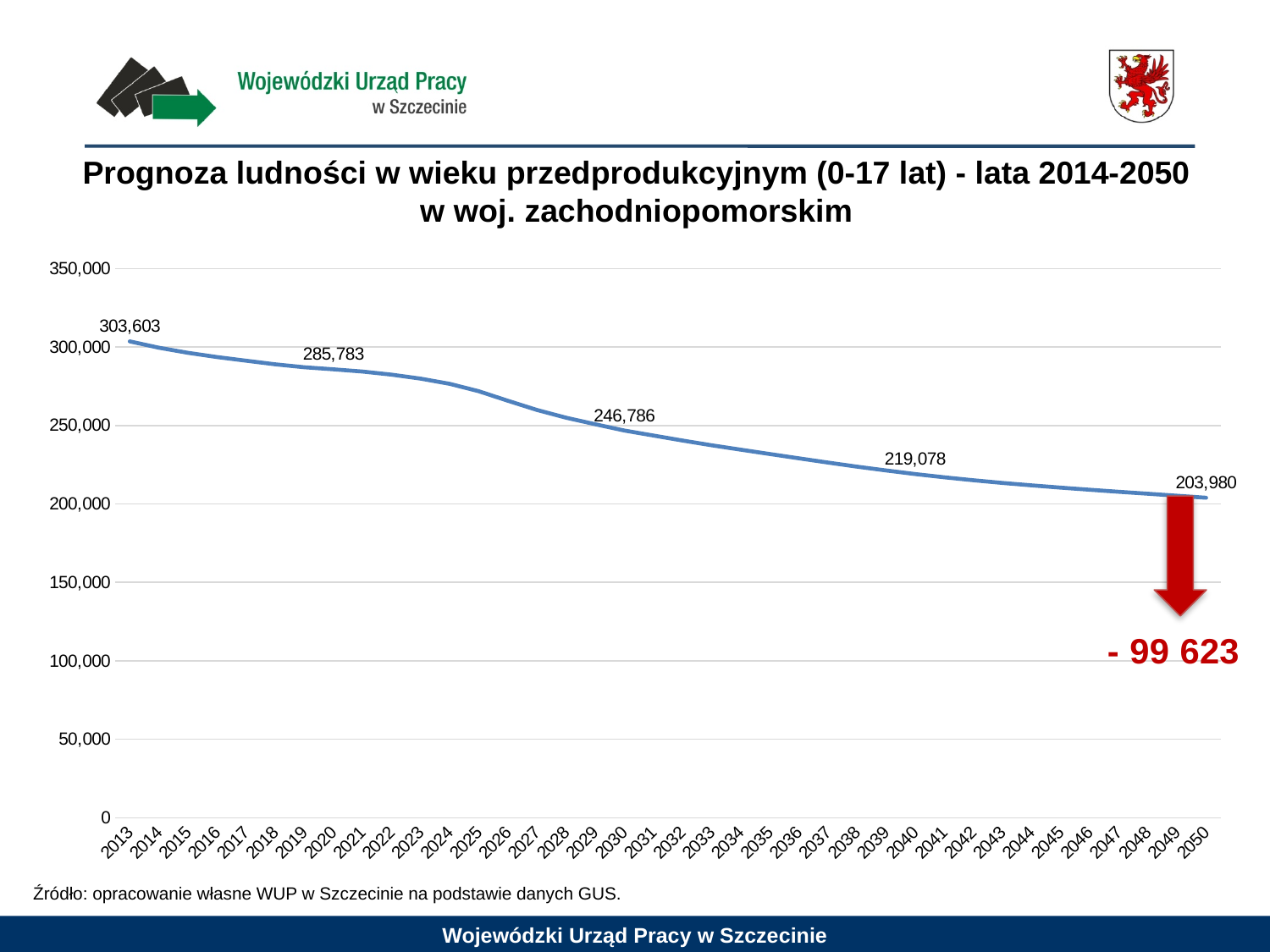
What is the projected population aged 0-17 for 2030? 246,786 Which year has the lowest value on the chart? 2050 What is the projected population aged 0-17 for 2040? 219,078 Which year has the highest value on the chart? 2013 What is the difference between the 2013 value and the 2050 value? 99,623 What is the projected population aged 0-17 for 2050? 203,980 Do the values rise or fall from 2013 to 2050? fall How many years are shown on the x axis? 38 What is the projected population aged 0-17 for 2013? 303,603 What kind of chart is shown on the slide? line chart Is the value for 2025 greater or less than 250,000? greater Is the value for 2035 greater or less than 250,000? less